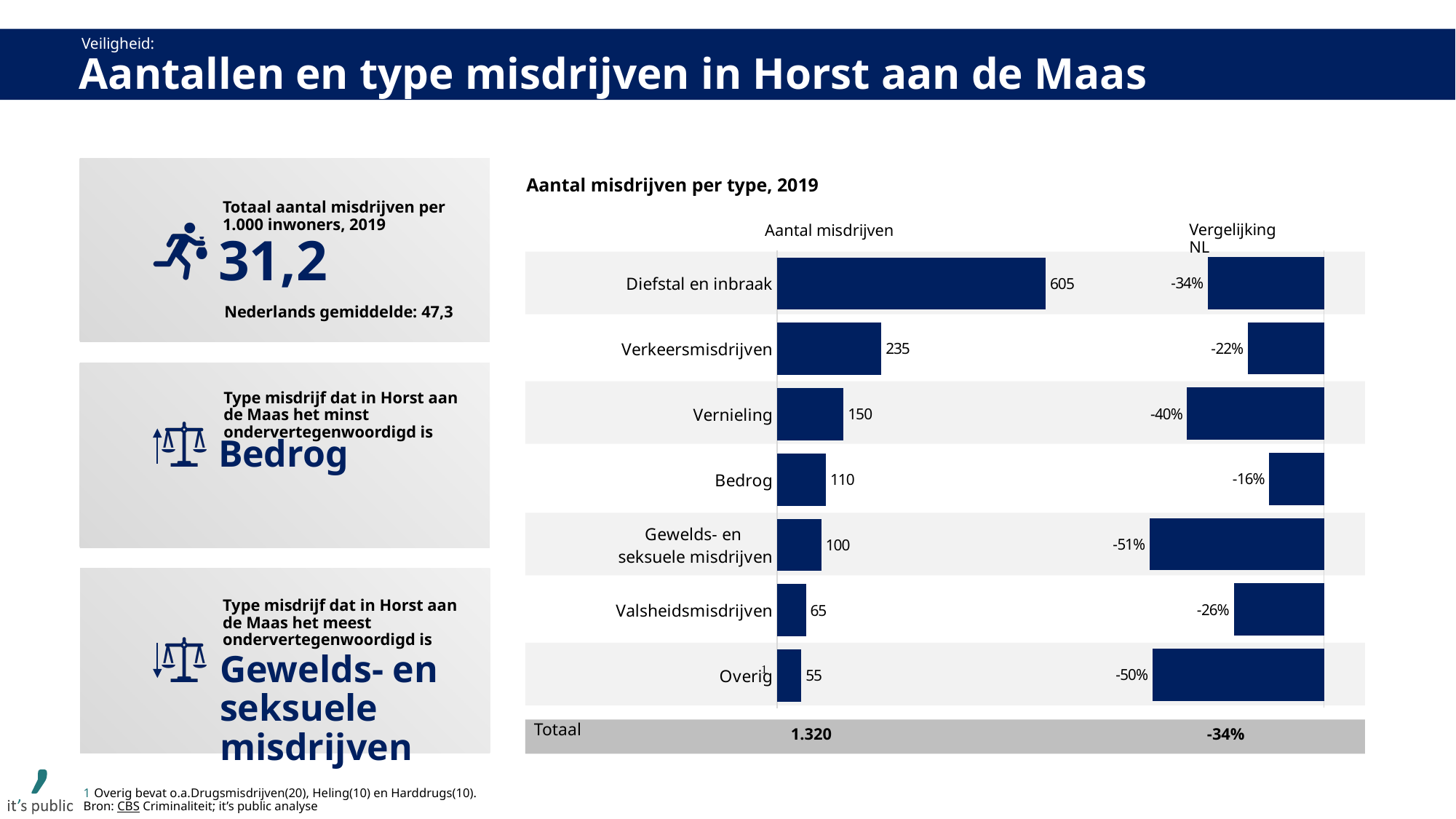
In the chart 'Aantal misdrijven per type, 2019', what is the Totaal value for Vergelijking NL? -34% In the chart 'Aantal misdrijven per type, 2019', what is the Vergelijking NL value for Bedrog? -16% In the chart 'Aantal misdrijven per type, 2019', which has more misdrijven: Vernieling or Bedrog? Vernieling In the chart 'Aantal misdrijven per type, 2019', what is the Aantal misdrijven value for Valsheidsmisdrijven? 65 In the chart 'Aantal misdrijven per type, 2019', which type has the highest Aantal misdrijven? Diefstal en inbraak In the chart 'Aantal misdrijven per type, 2019', how many misdrijven are shown for Diefstal en inbraak? 605 What kind of chart is 'Aantal misdrijven per type, 2019'? Bar chart In the chart 'Aantal misdrijven per type, 2019', how many crime types are listed (excluding Totaal)? 7 In the chart 'Aantal misdrijven per type, 2019', what is the difference in Aantal misdrijven between Diefstal en inbraak and Verkeersmisdrijven? 370 In the chart 'Aantal misdrijven per type, 2019', which type has the lowest Aantal misdrijven? Overig In the chart 'Aantal misdrijven per type, 2019', what is the Vergelijking NL value for Gewelds- en seksuele misdrijven? -51% In the chart 'Aantal misdrijven per type, 2019', what is the Totaal for Aantal misdrijven? 1.320